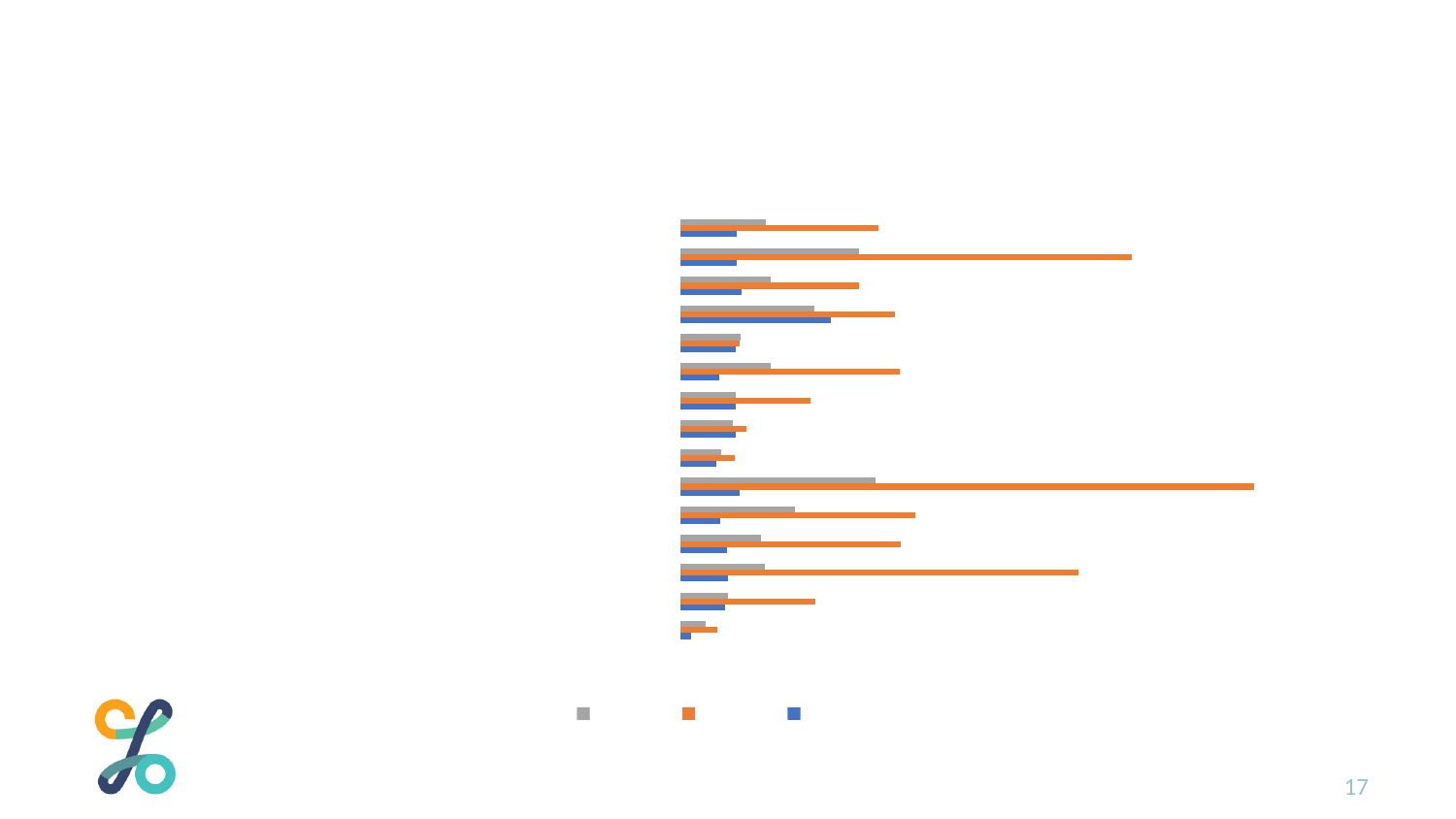
Are the bars on the chart horizontal or vertical? horizontal How many groups of bars are plotted on the chart? 15 How many series does the legend list? 3 What kind of chart is shown on the slide? bar chart What three colours are used for the series in the legend? grey, orange and blue Which colour series has the single longest bar on the chart? orange